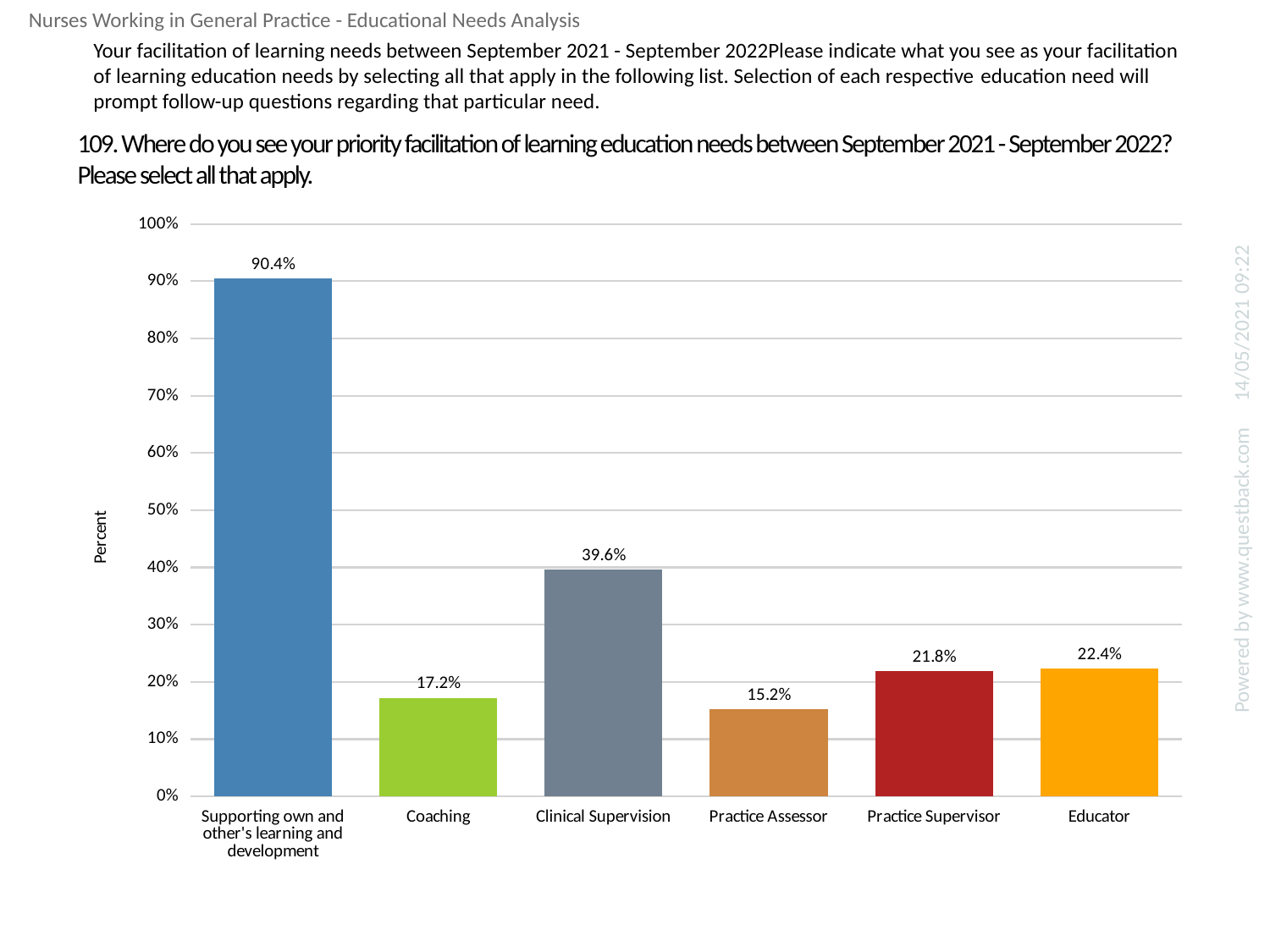
How many categories are shown on the x axis? 6 What is the difference between the values for Supporting own and other's learning and development and Clinical Supervision? 50.8% What is the difference between the values for Educator and Practice Assessor? 7.2% What percentage is shown for Clinical Supervision? 39.6% What is the label of the y axis? Percent What percentage is shown for Practice Supervisor? 21.8% What is the value for Coaching? 17.2% Is the value for Clinical Supervision greater or less than 50%? less Which is larger, the value for Coaching or the value for Practice Supervisor? Practice Supervisor Which category has the lowest value? Practice Assessor Which category has the highest value? Supporting own and other's learning and development What kind of chart is shown on the slide? bar chart